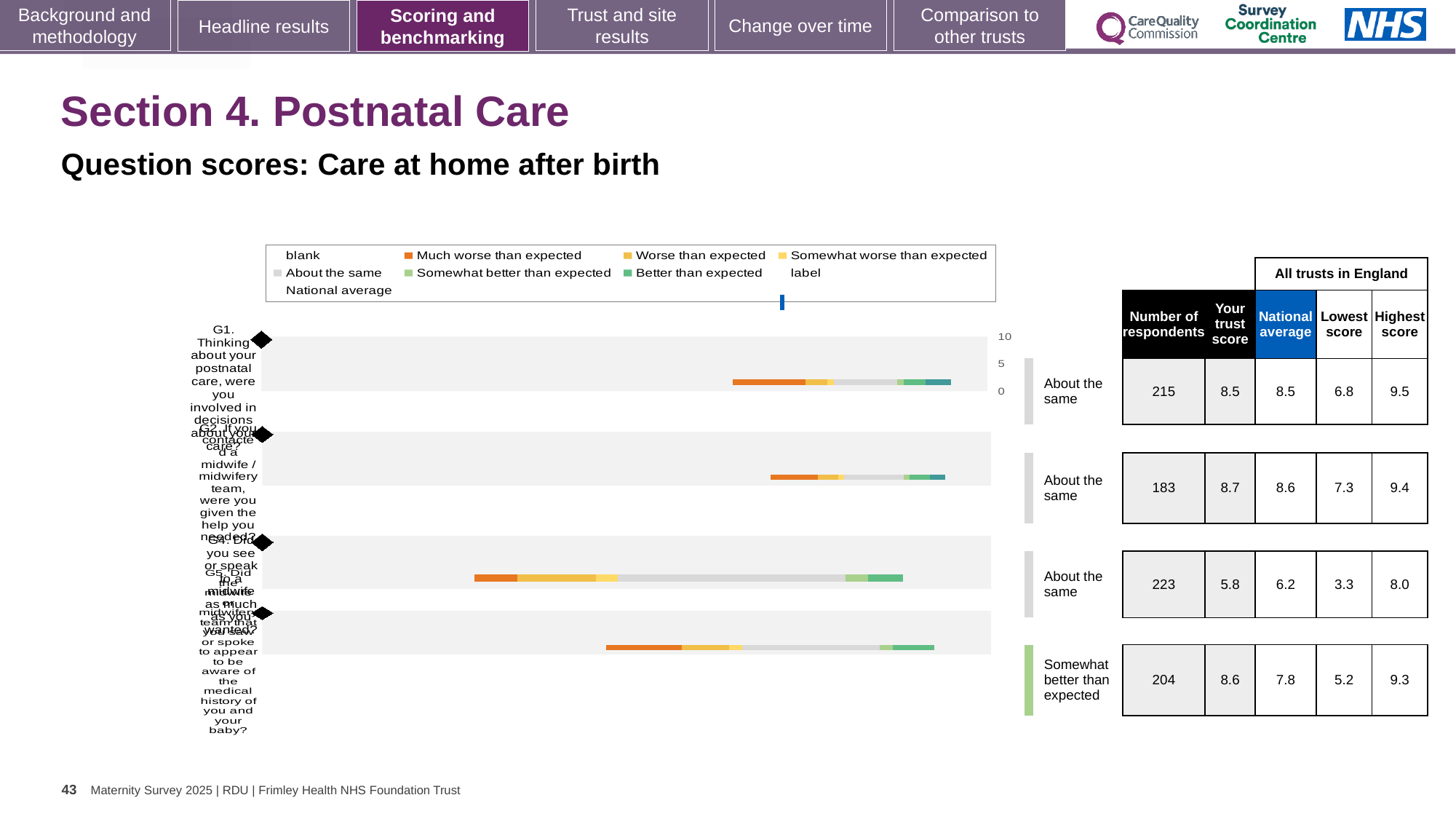
For the fourth (bottom) question bar, how much higher is the trust score than the national average? 0.8 How many question bars are plotted in the chart? 4 What kind of chart is shown on the slide? bar chart For the third question bar, what is the difference between the highest score and the lowest score across all trusts in England? 4.7 Which question bar has the highest number of respondents? the third bar (223) For the fourth (bottom) question bar, which is larger: the trust score or the national average? the trust score (8.6) What benchmark category is shown for the fourth (bottom) question bar? Somewhat better than expected What is the national average for the second question bar? 8.6 What is the subtitle describing the question scores shown in the chart? Question scores: Care at home after birth What is the number of respondents for the third question bar? 223 Which question bar has the lowest 'Your trust score'? the third bar (5.8) What is the 'Your trust score' value for the first (top) question bar? 8.5